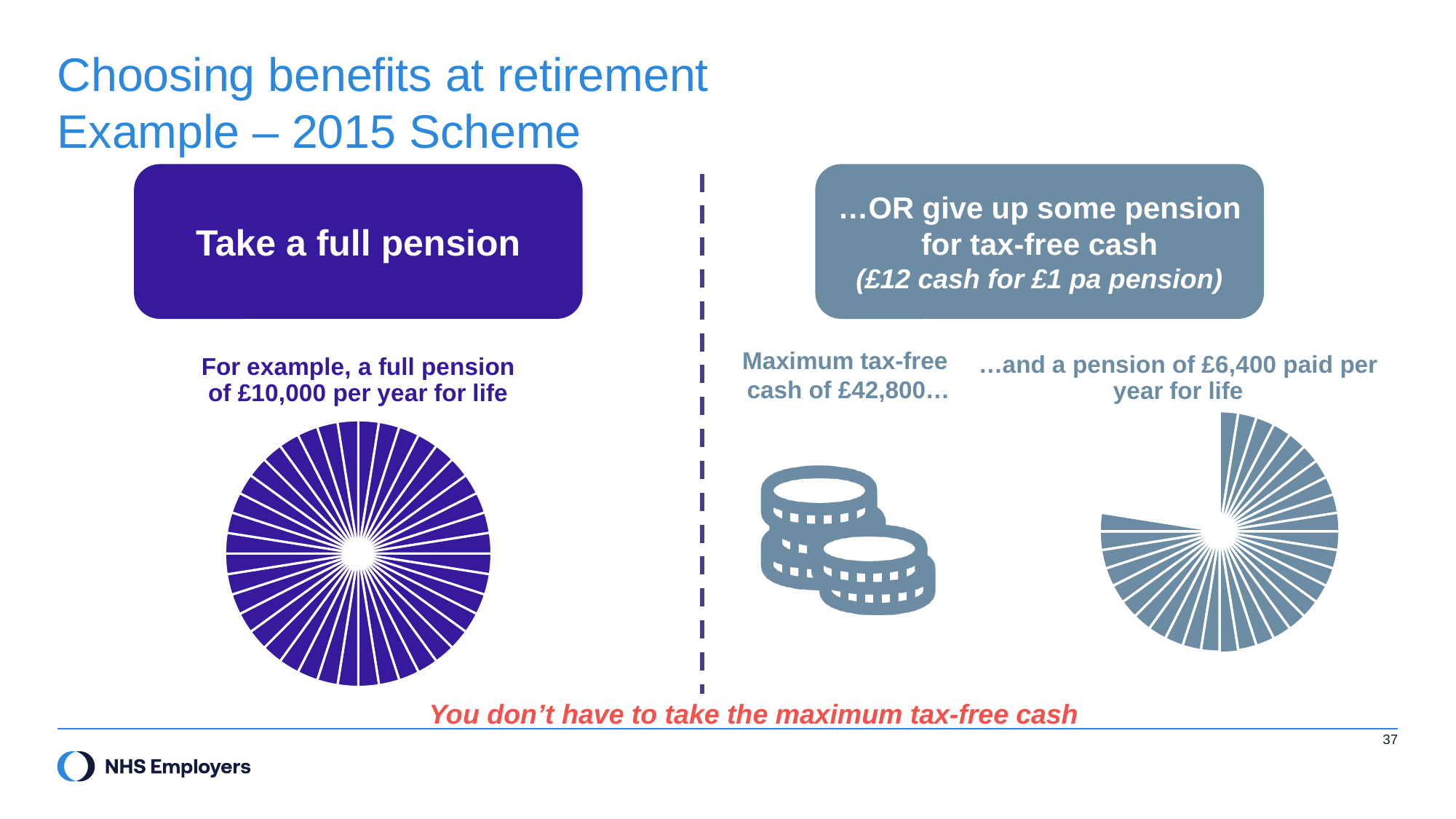
On the left chart, what is the full pension per year shown in the example? £10,000 per year What kind of chart is shown under 'Take a full pension' on the left of the slide? Pie chart What colour is the full-pension pie chart on the left of the slide? Purple On the right-hand pie chart, what pension per year is shown after giving up some pension for tax-free cash? £6,400 What exchange rate of cash for pension is stated in the right-hand heading box? £12 cash for £1 pa pension Is the reduced pension shown on the right-hand chart greater or less than £10,000 per year? less Which is larger: the full pension per year on the left chart or the reduced pension per year on the right chart? The full pension (£10,000) On the right side of the slide, what is the maximum tax-free cash shown? £42,800 What is the difference between the full pension of £10,000 per year and the reduced pension of £6,400 per year? £3,600